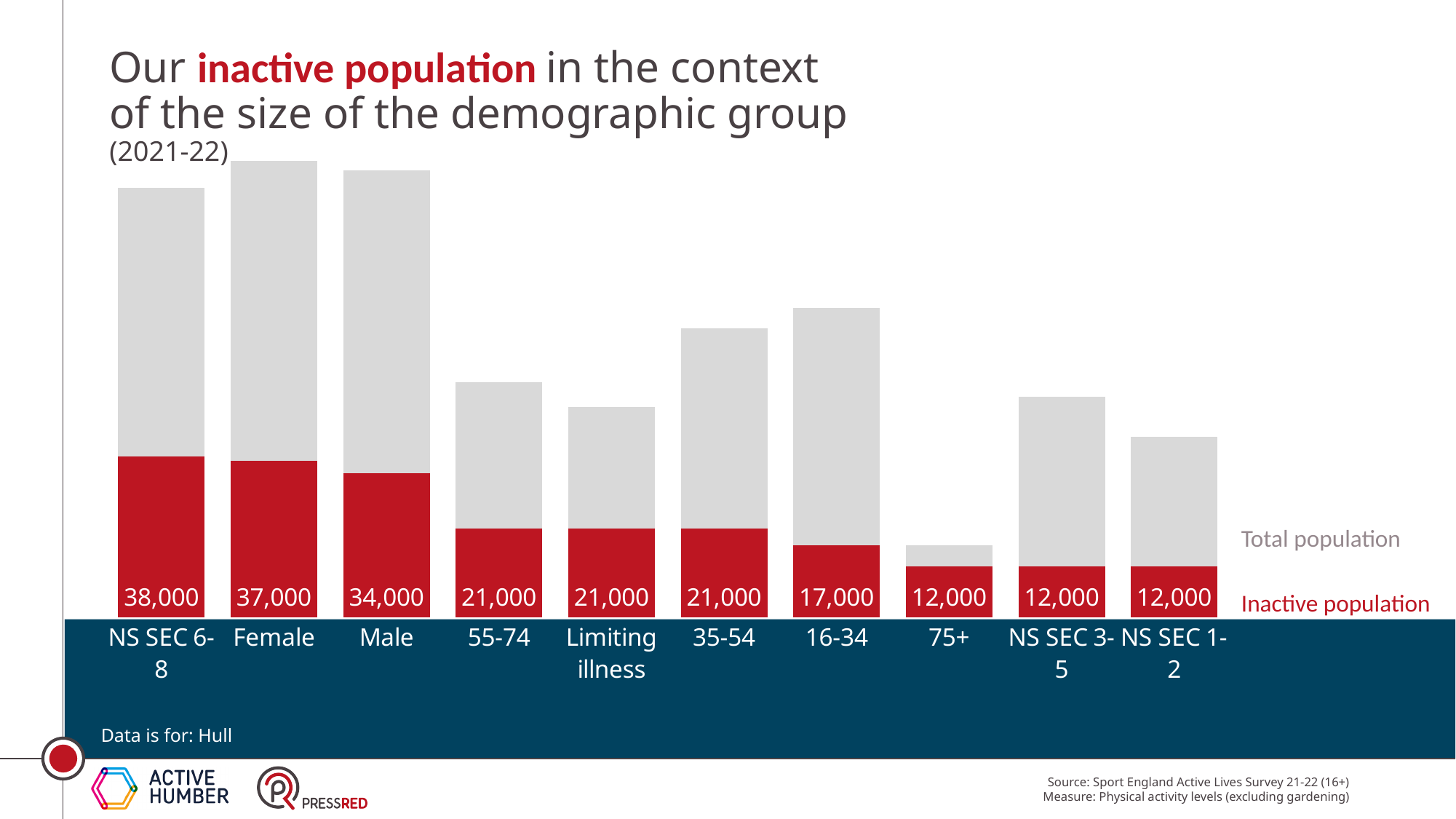
What kind of chart is shown on the slide? Bar chart Which group has a larger total population, 16-34 or 35-54? 16-34 Which has a larger inactive population, Female or Male? Female What is the inactive population for the Limiting illness group? 21,000 What is the inactive population for the 16-34 age group? 17,000 What is the inactive population for the NS SEC 6-8 group? 38,000 Which colour represents the inactive population in the chart? Red How many series does the chart legend list? 2 Which demographic group has the highest inactive population? NS SEC 6-8 What is the inactive population for the Female group? 37,000 What is the difference between the inactive population of NS SEC 6-8 and Male? 4,000 How many demographic groups are shown on the chart? 10